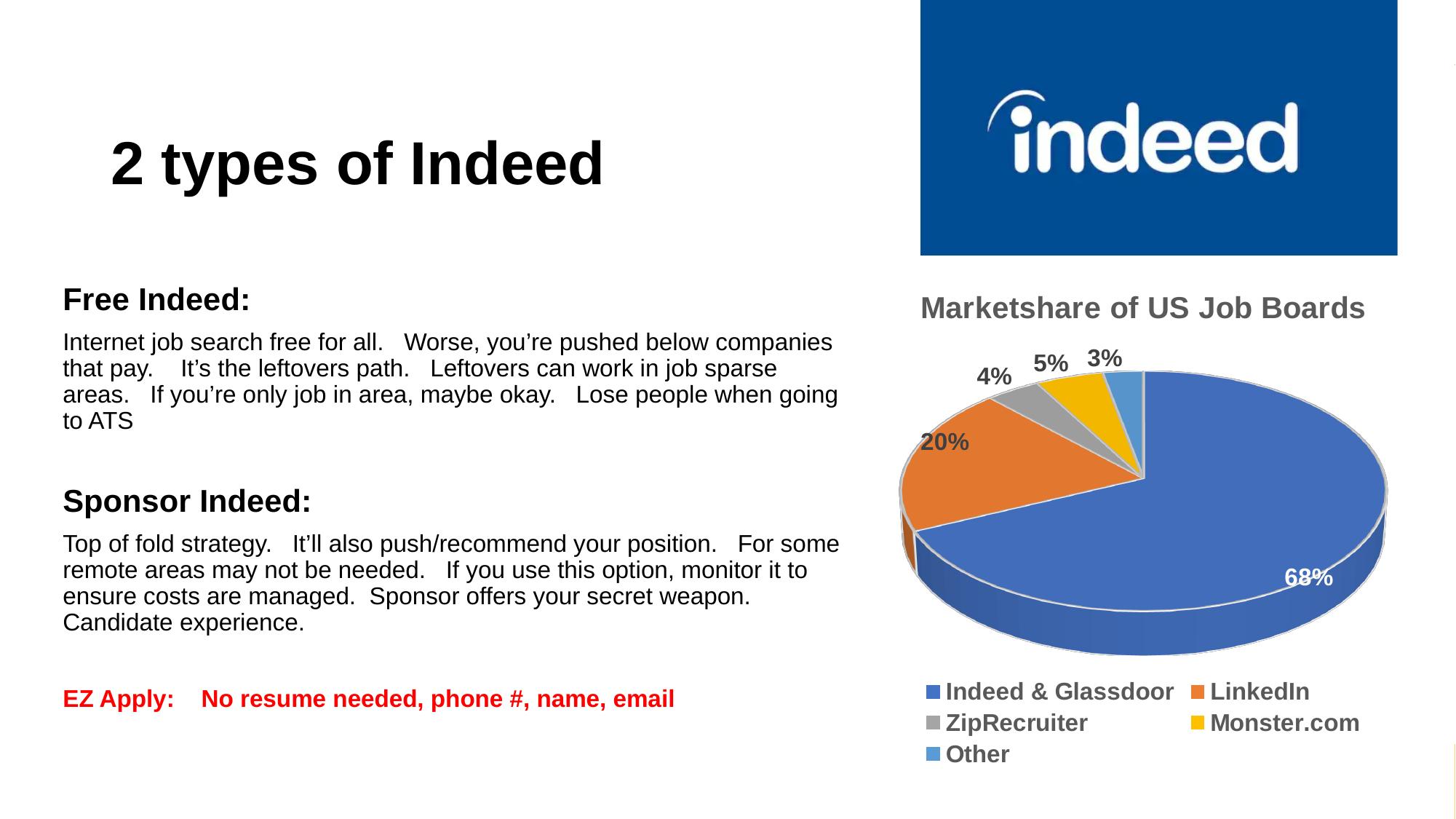
What share of the pie does Other hold? 3% What share of the pie does LinkedIn hold? 20% What share of the pie does Monster.com hold? 5% Which has a larger share, Monster.com or ZipRecruiter? Monster.com What share of the pie does ZipRecruiter hold? 4% Which job board has the largest share of the pie? Indeed & Glassdoor What share of the pie does Indeed & Glassdoor hold? 68% What is the title of the chart? Marketshare of US Job Boards How many categories does the legend list? 5 Which category has the smallest share of the pie? Other What is the difference in share between Indeed & Glassdoor and LinkedIn? 48% What type of chart is shown on the slide? pie chart